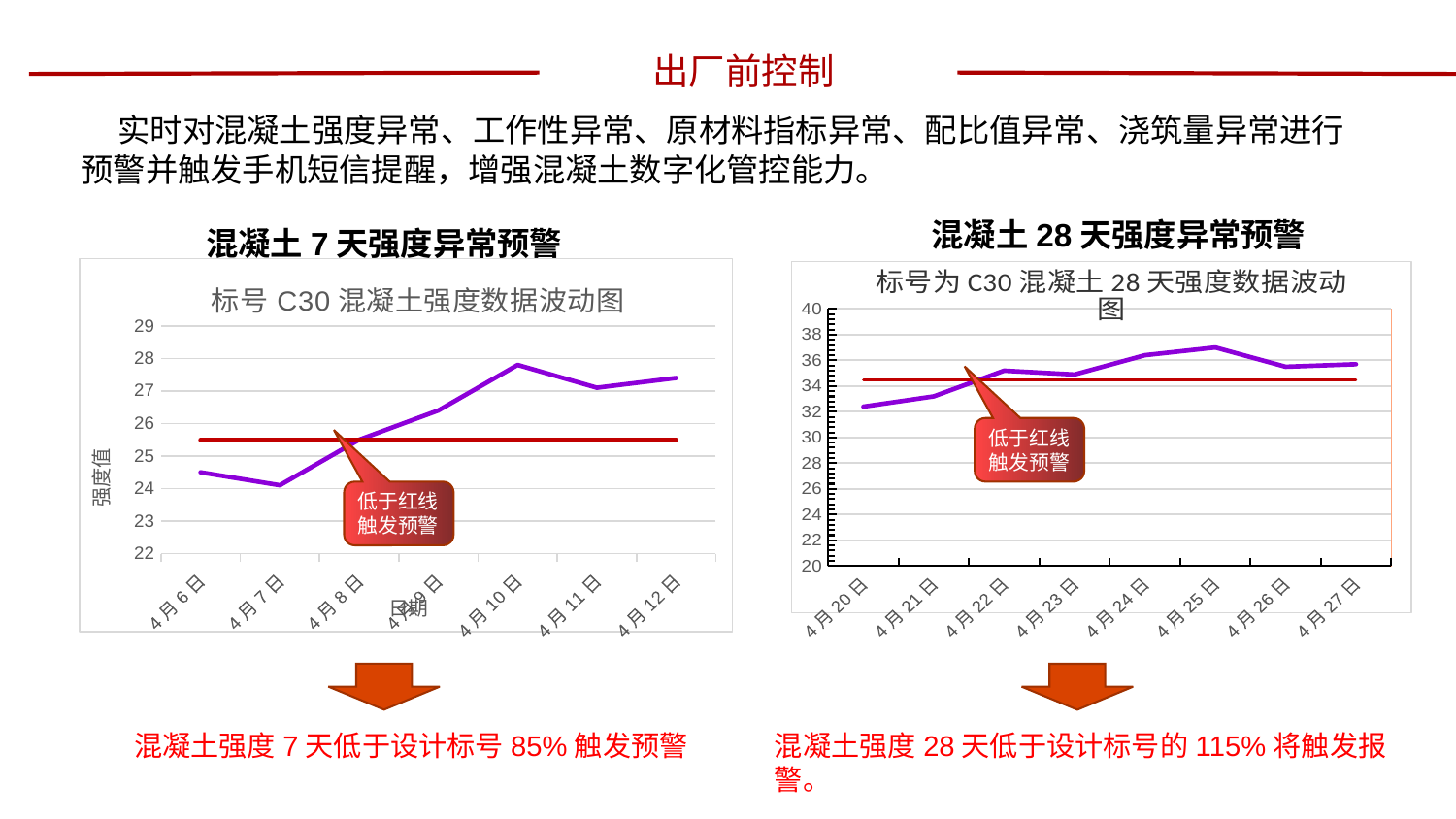
In the right chart (标号为 C30 混凝土 28 天强度数据波动图), which is larger, the value for 4月25日 or the value for 4月21日? 4月25日 In the left chart (标号 C30 混凝土强度数据波动图), how many dates are plotted on the x axis? 7 In the left chart (标号 C30 混凝土强度数据波动图), on which date is the strength value highest? 4月10日 In the right chart (标号为 C30 混凝土 28 天强度数据波动图), how many dates are plotted on the x axis? 8 What kind of chart is the left chart titled 标号 C30 混凝土强度数据波动图? line chart In the left chart (标号 C30 混凝土强度数据波动图), is the value for 4月6日 greater or less than 25? less In the right chart (标号为 C30 混凝土 28 天强度数据波动图), is the value for 4月20日 greater or less than 34? less What is the y-axis title of the left chart (标号 C30 混凝土强度数据波动图)? 强度值 In the right chart (标号为 C30 混凝土 28 天强度数据波动图), on which date is the strength value highest? 4月25日 In the left chart (标号 C30 混凝土强度数据波动图), on which date is the strength value lowest? 4月7日 In the left chart (标号 C30 混凝土强度数据波动图), is the value for 4月10日 greater or less than 27? greater In the right chart (标号为 C30 混凝土 28 天强度数据波动图), on which date is the strength value lowest? 4月20日